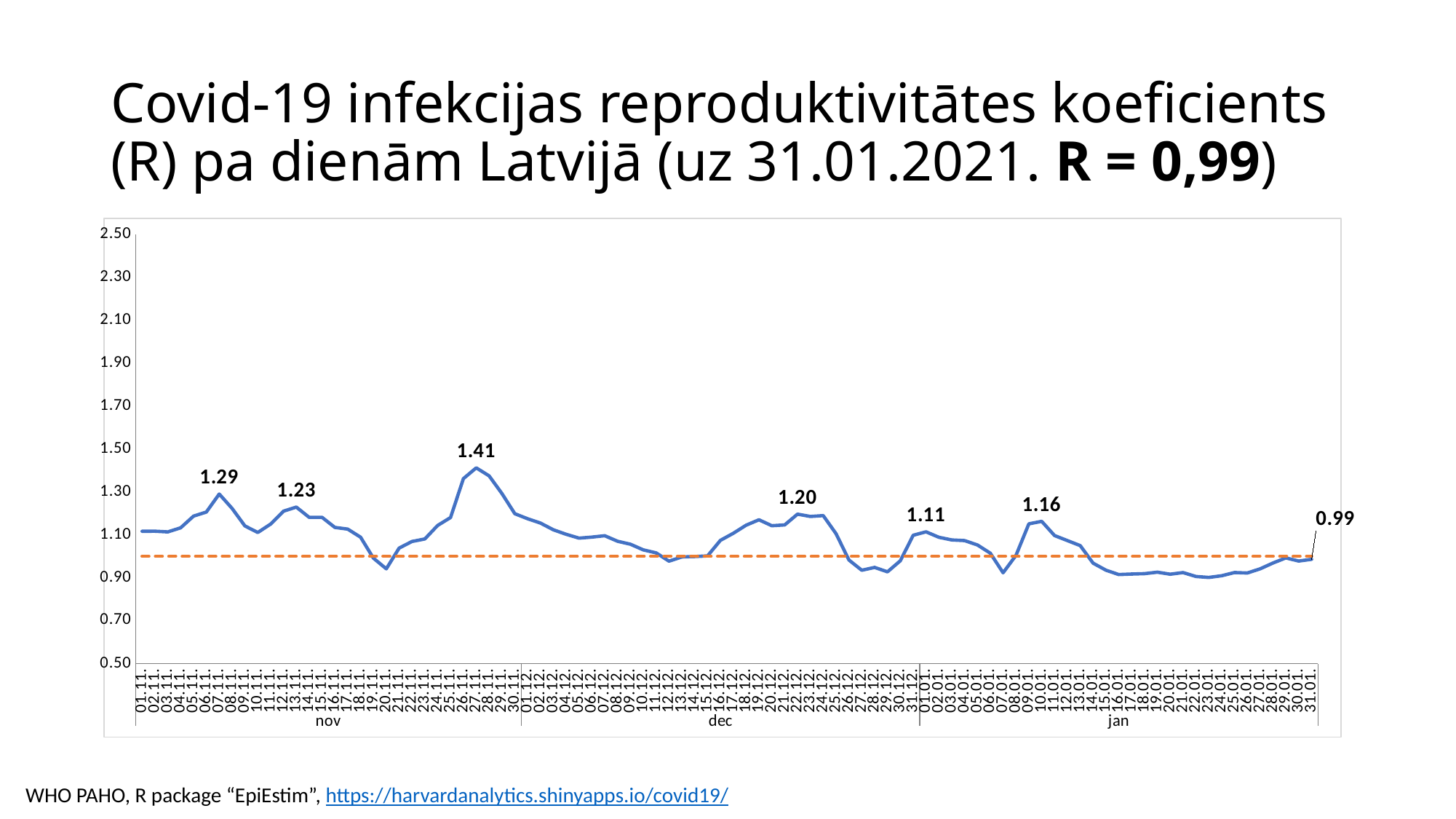
What is the highest labelled R value on the chart? 1.41 What is the R value labelled at the peak around 27.11? 1.41 What is the difference between the labelled values 1.20 and 1.11? 0.09 Which labelled peak is larger: the one around 07.11 or the one around 13.11? 07.11 (1.29) What kind of chart is shown on the slide? line chart What is the R value labelled at the end of the series on 31.01? 0.99 Is the R value on 22.01 greater or less than 1.00? less What is the difference between the labelled peak of 1.41 and the labelled peak of 1.29? 0.12 Is the R value on 20.11 greater or less than 1.00? less How many months are labelled along the x axis? 3 What is the R value labelled at the peak around 07.11? 1.29